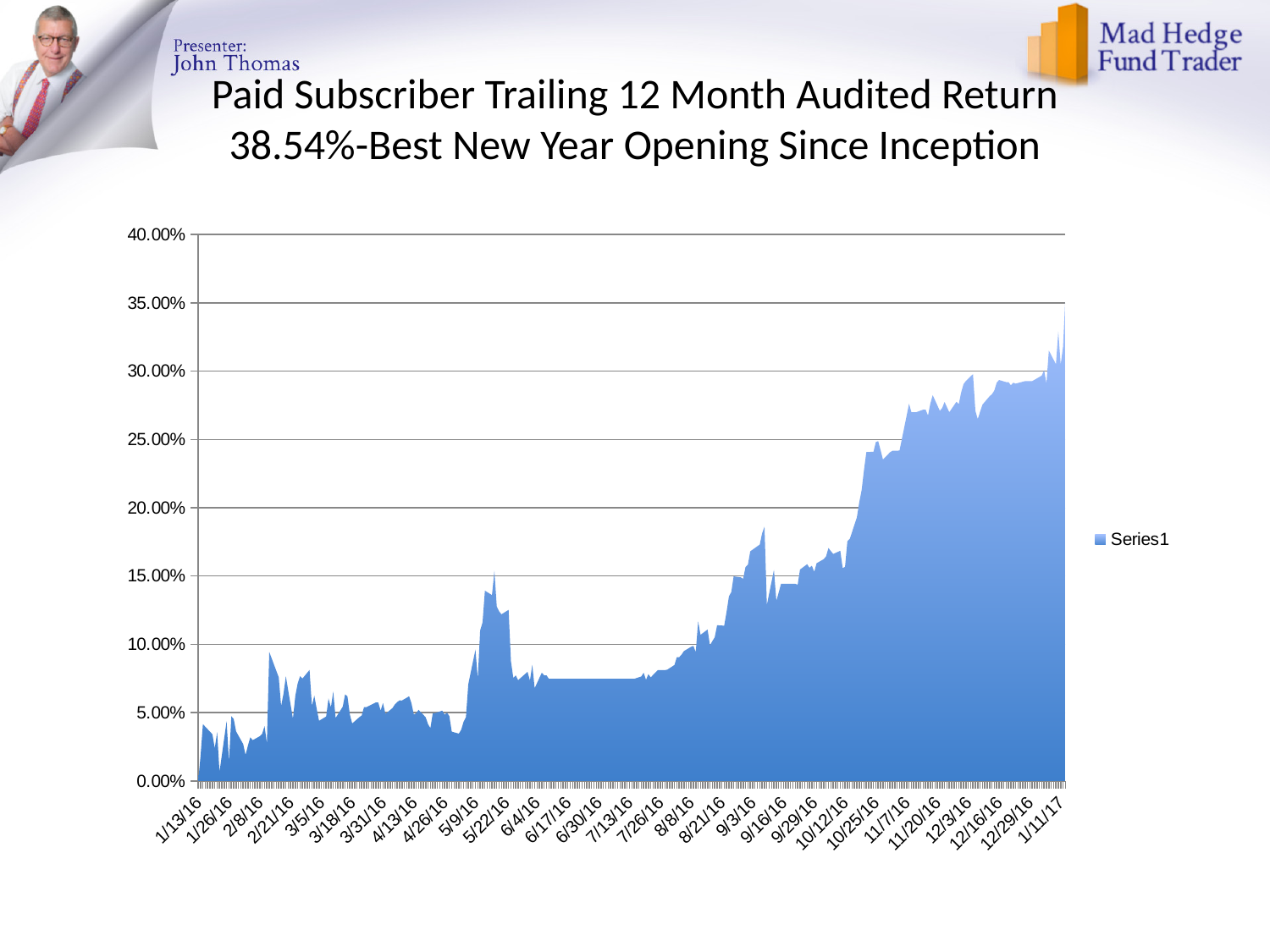
Which is larger, the value at 9/29/16 or the value at 3/5/16? 9/29/16 How many series does the legend list? 1 Is the value at 1/13/16 greater or less than 5.00%? less What is the title of the chart on the slide? Paid Subscriber Trailing 12 Month Audited Return 38.54%-Best New Year Opening Since Inception What is the name of the series shown in the legend? Series1 Which is larger, the value at 1/13/16 or the value at 1/11/17? 1/11/17 Overall, do the values rise or fall from 1/13/16 to 1/11/17? Rise Is the value at 7/13/16 greater or less than 10.00%? less What kind of chart is shown on the slide? Area chart Is the value at 10/25/16 greater or less than 20.00%? greater